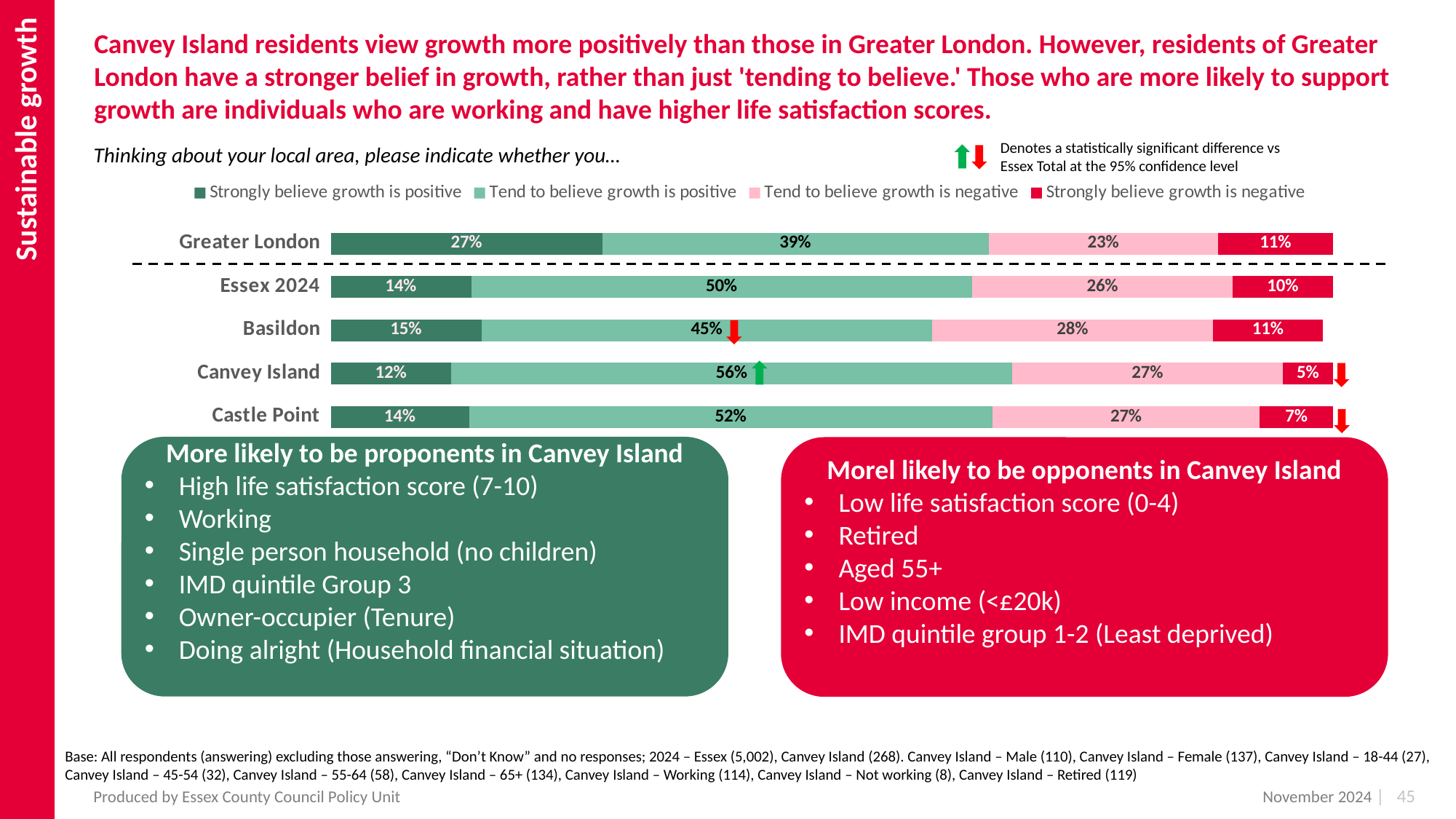
Which is larger: the 'Strongly believe growth is positive' value for Greater London or for Essex 2024? Greater London What percentage of Castle Point residents strongly believe growth is negative? 7% What do the green and red arrows next to some bars denote? A statistically significant difference vs Essex Total at the 95% confidence level What percentage of Greater London residents strongly believe growth is positive? 27% What is the difference between the 'Tend to believe growth is positive' values for Canvey Island and Greater London? 17 percentage points How many series does the legend list? 4 What percentage of Canvey Island residents tend to believe growth is positive? 56% Which area has the lowest share of residents who strongly believe growth is negative? Canvey Island What is the combined percentage of Basildon residents who strongly or tend to believe growth is positive? 60% How many areas are shown in the chart? 5 What kind of chart is shown on the slide? Stacked bar chart Which area has the highest share of residents who tend to believe growth is positive? Canvey Island